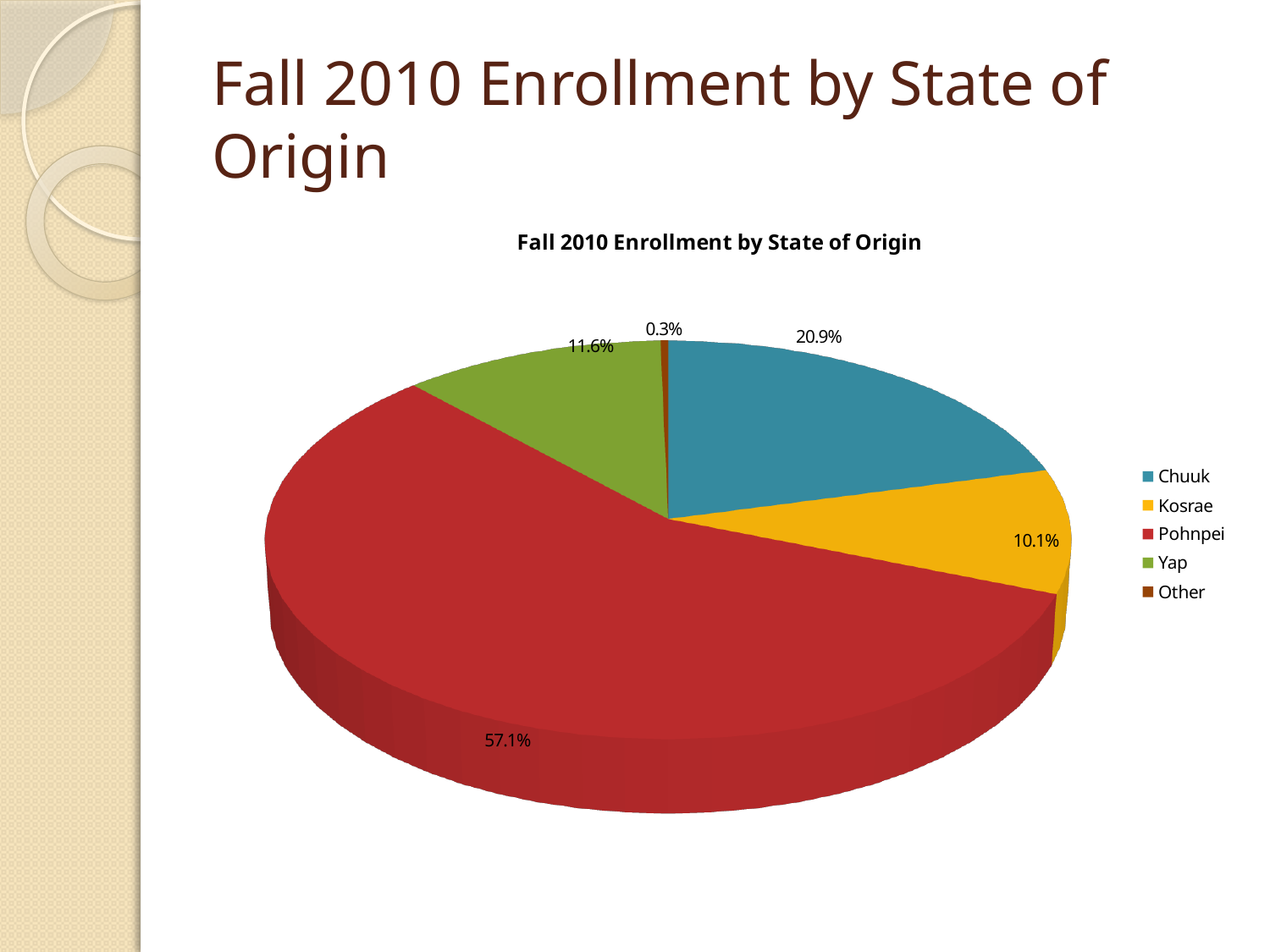
Which category has the smallest share of Fall 2010 enrollment? Other What kind of chart is shown on the slide? Pie chart What share of Fall 2010 enrollment came from Chuuk? 20.9% What share of Fall 2010 enrollment came from Yap? 11.6% How many percentage points larger is Pohnpei's share than Chuuk's share? 36.2 What share of Fall 2010 enrollment came from Pohnpei? 57.1% Which has a larger share of enrollment, Yap or Kosrae? Yap Which state of origin has the largest share of Fall 2010 enrollment? Pohnpei How many categories does the pie chart show? 5 What colour represents Pohnpei in the pie chart? Red